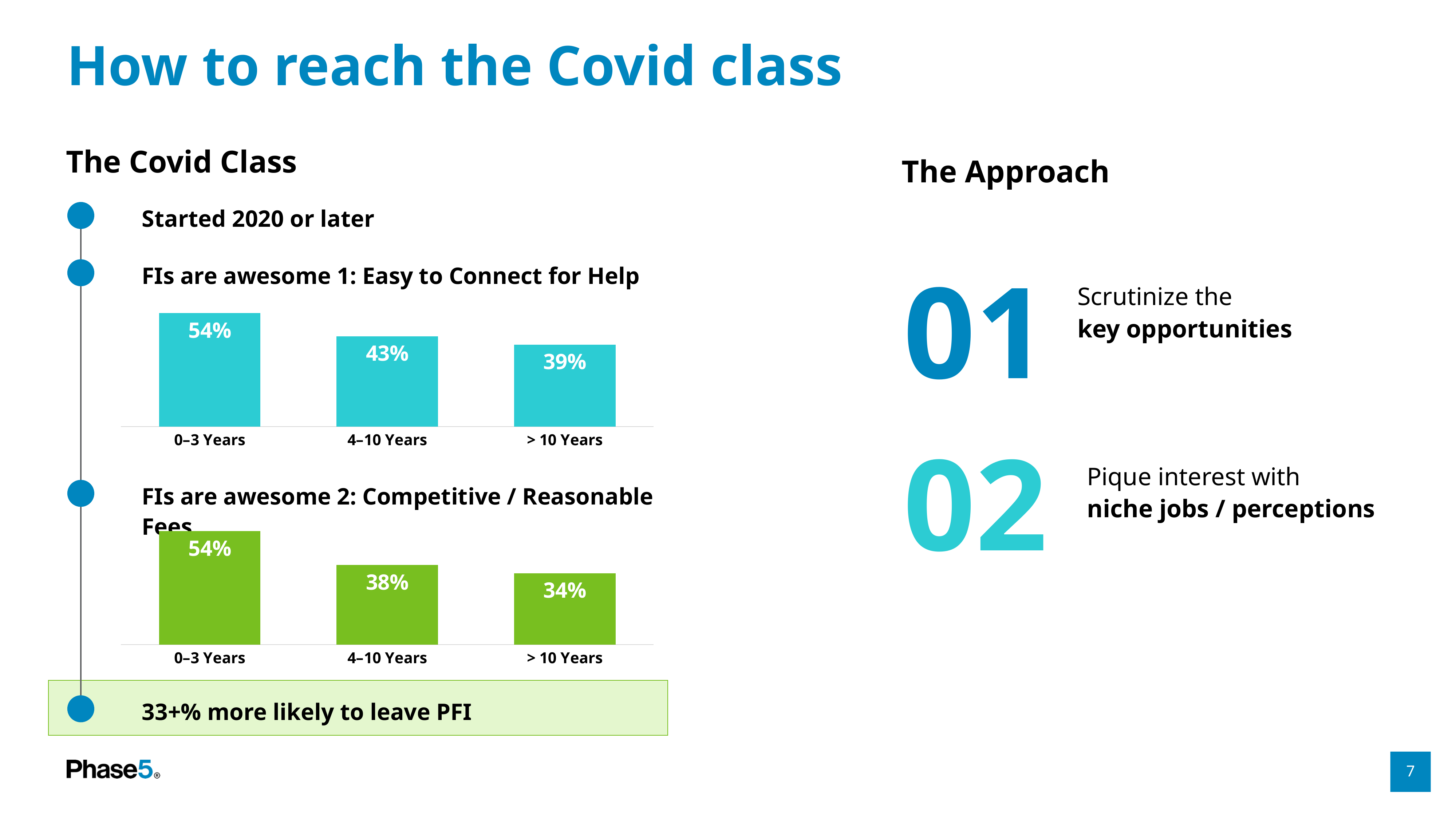
In the 'FIs are awesome 2: Competitive / Reasonable Fees' chart, what is the difference between the 0–3 Years and 4–10 Years values? 16% In the 'FIs are awesome 1: Easy to Connect for Help' chart, do the values rise or fall from 0–3 Years to > 10 Years? fall Which is larger: the 4–10 Years value in the 'Easy to Connect for Help' chart or the 4–10 Years value in the 'Competitive / Reasonable Fees' chart? Easy to Connect for Help (43%) In the 'FIs are awesome 2: Competitive / Reasonable Fees' chart, how many categories are shown? 3 In the 'FIs are awesome 2: Competitive / Reasonable Fees' chart, what is the value for 4–10 Years? 38% In the 'FIs are awesome 2: Competitive / Reasonable Fees' chart, which category has the highest value? 0–3 Years In the 'FIs are awesome 2: Competitive / Reasonable Fees' chart, what is the value for > 10 Years? 34% In the 'FIs are awesome 1: Easy to Connect for Help' chart, what is the value for 4–10 Years? 43% In the 'FIs are awesome 1: Easy to Connect for Help' chart, what is the value for 0–3 Years? 54% In the 'FIs are awesome 1: Easy to Connect for Help' chart, what is the difference between the 0–3 Years and > 10 Years values? 15% In the 'FIs are awesome 1: Easy to Connect for Help' chart, which category has the lowest value? > 10 Years What kind of chart is the 'FIs are awesome 1: Easy to Connect for Help' chart? bar chart